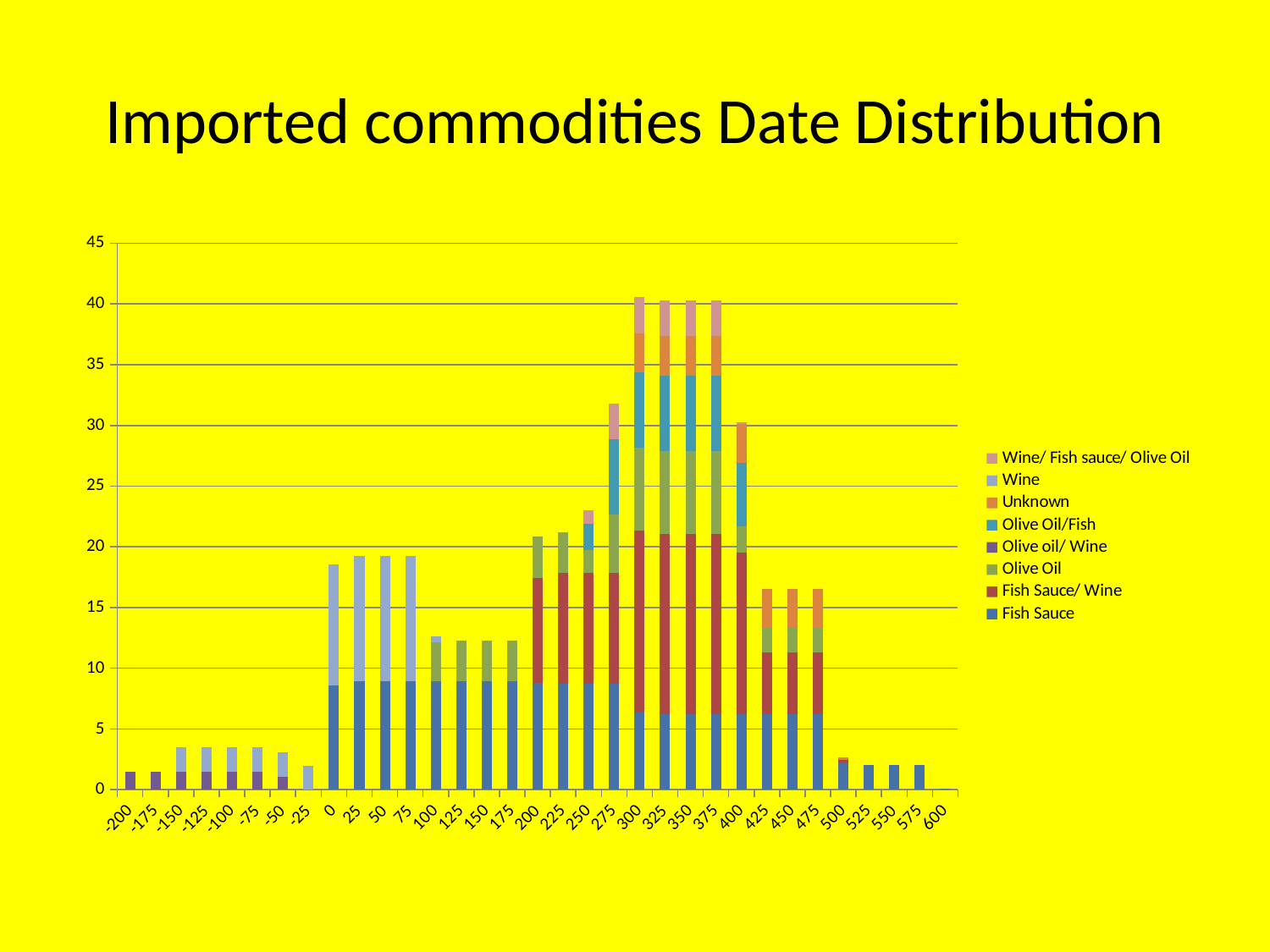
Which bar is taller, the one for 0 or the one for 100? 0 What kind of chart is shown on the slide? Stacked bar chart Is the total value of the bar for 0 greater or less than 15? greater Is the total value of the bar for 400 greater or less than 25? greater Do the bar totals rise or fall along the x axis from 375 to 525? fall Which series is listed first (at the top) in the legend? Wine/ Fish sauce/ Olive Oil Is the total value of the bar for 100 greater or less than 10? greater How many series does the legend list? 8 How many categories are shown along the x axis? 33 Which bar is taller, the one for 400 or the one for 425? 400 What is the title of the chart? Imported commodities Date Distribution